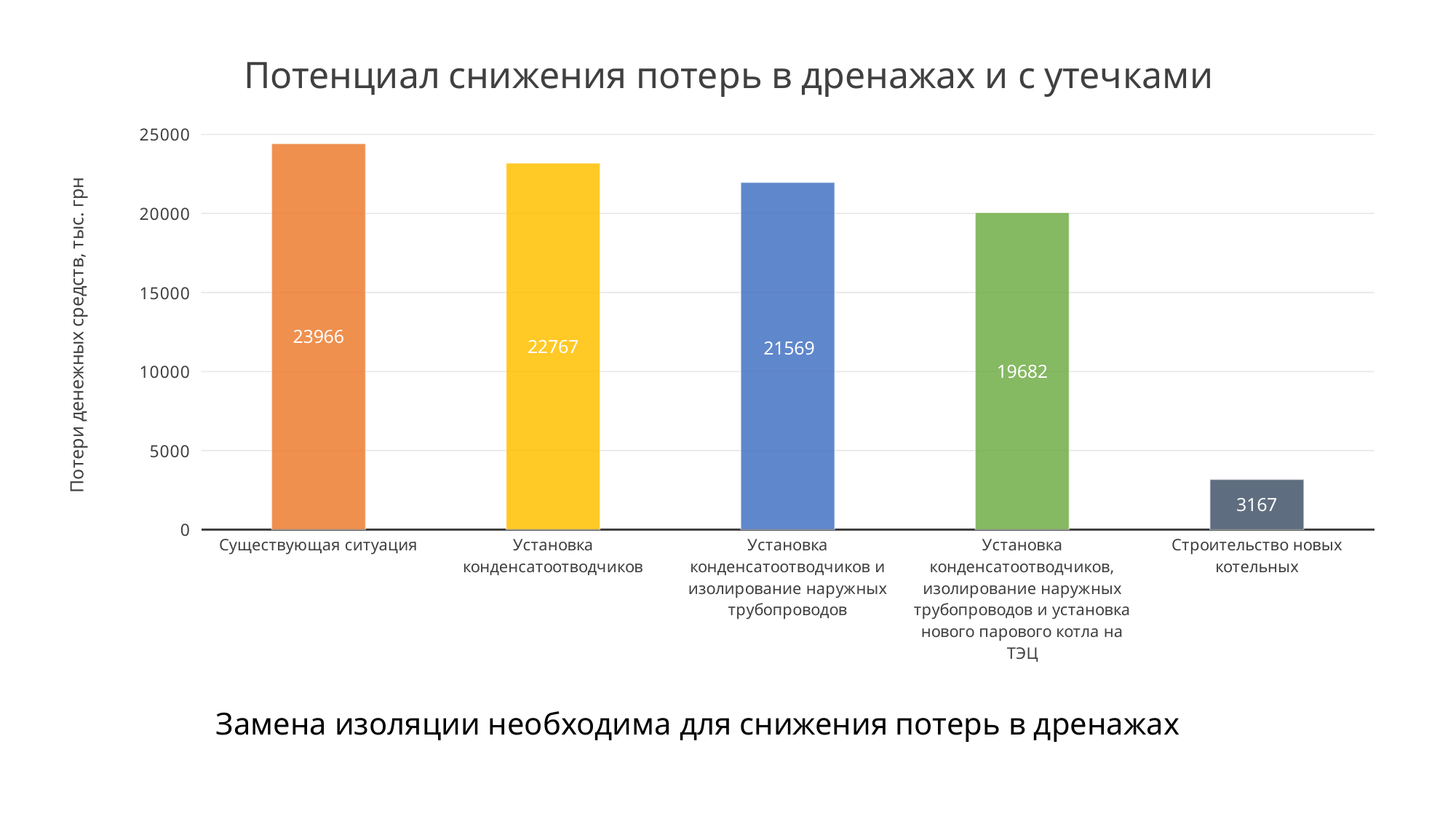
Which category has the lowest value? Строительство новых котельных What is the value for «Строительство новых котельных»? 3167 Which category has the highest value? Существующая ситуация What is the difference between «Существующая ситуация» and «Установка конденсатоотводчиков»? 1199 Which is larger: the value for «Установка конденсатоотводчиков» or the value for «Установка конденсатоотводчиков, изолирование наружных трубопроводов и установка нового парового котла на ТЭЦ»? Установка конденсатоотводчиков Is the value for «Строительство новых котельных» greater or less than 5000? less What is the difference between «Установка конденсатоотводчиков и изолирование наружных трубопроводов» and «Строительство новых котельных»? 18402 What is the value for «Установка конденсатоотводчиков»? 22767 How many categories are shown in the chart? 5 Do the values rise or fall from left to right along the x axis? fall What is the value for «Существующая ситуация»? 23966 What kind of chart is shown on the slide? bar chart